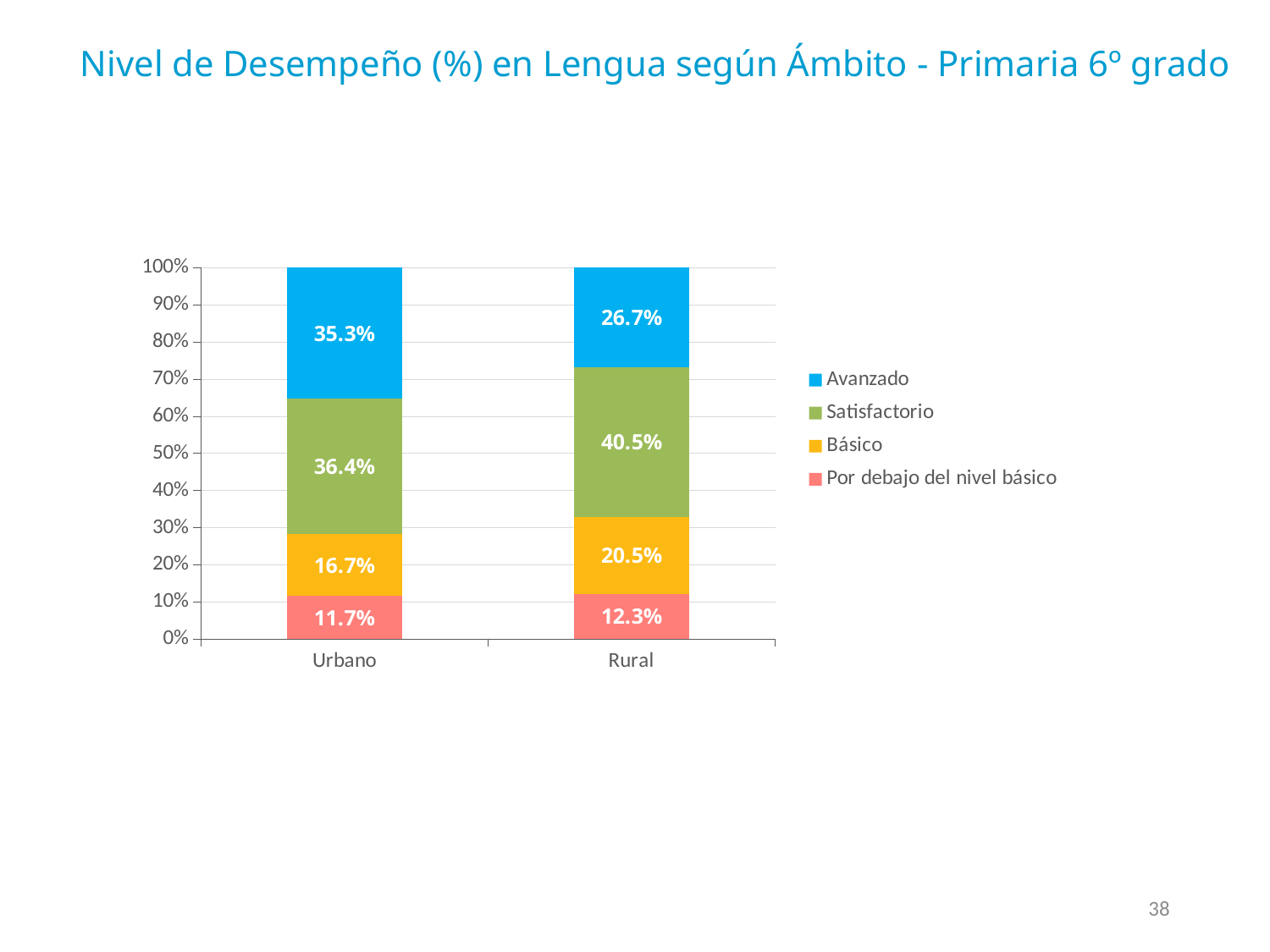
What is the Por debajo del nivel básico value for Rural? 12.3% How many categories are shown on the x axis? 2 What is the difference between the Básico values for Rural and Urbano? 3.8% Which category has the higher Avanzado value, Urbano or Rural? Urbano What is the Satisfactorio value for Rural? 40.5% What is the Avanzado value for Urbano? 35.3% How many series does the legend list? 4 What is the Básico value for Urbano? 16.7% Which category has the higher Satisfactorio value, Urbano or Rural? Rural What kind of chart is shown on the slide? Stacked bar chart Which series has the lowest value for Urbano? Por debajo del nivel básico What is the difference between the Avanzado values for Urbano and Rural? 8.6%